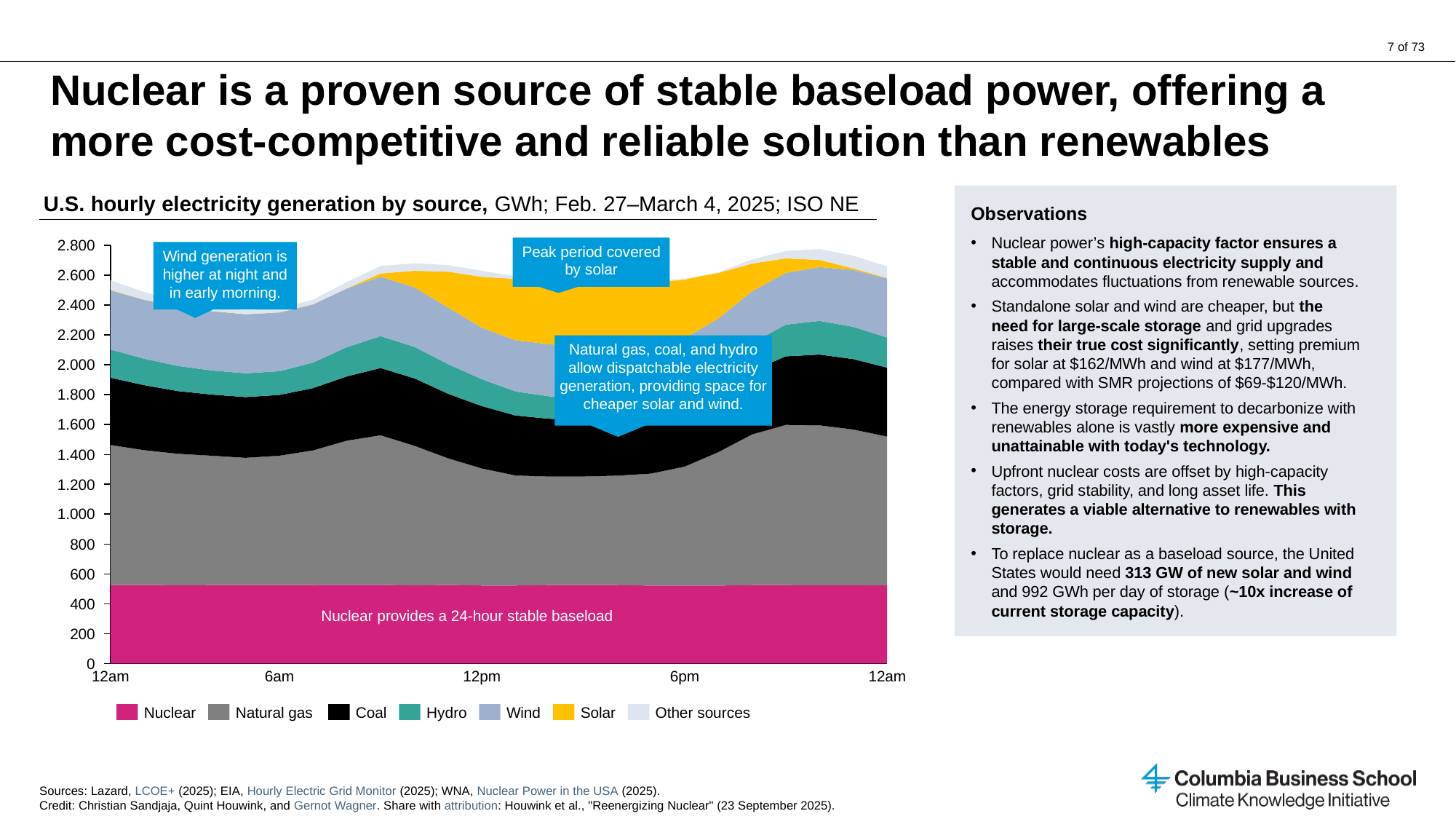
What kind of chart is shown on the slide? Stacked area chart Is the value for Nuclear at 12pm greater or less than 400? greater Is the value for Nuclear at 12am greater or less than 600? less Is the total generation at the first 12am point greater or less than 2,600? less How many time labels are shown on the x axis? 5 Which series forms the bottom layer of the stacked area chart? Nuclear Which series is larger at 6am, Natural gas or Coal? Natural gas Does the Solar band rise or fall from 6am to 12pm? rise Which series is larger at 12pm, Solar or Hydro? Solar What is the title of the chart? U.S. hourly electricity generation by source How many series does the chart legend list? 7